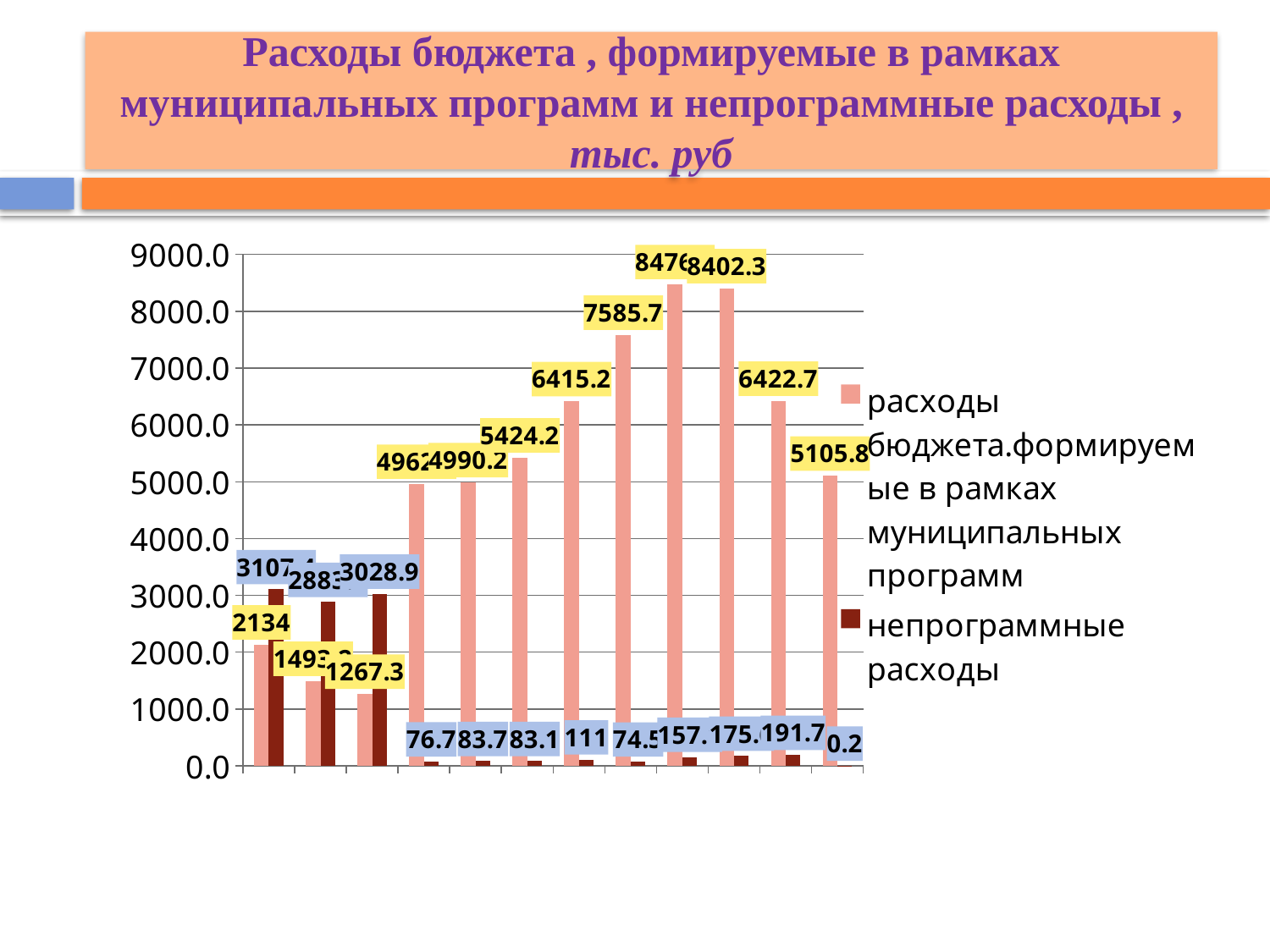
What is the lowest value in the 'непрограммные расходы' series? 0.2 In the first category, which series has the larger value: 'расходы бюджета, формируемые в рамках муниципальных программ' or 'непрограммные расходы'? непрограммные расходы What kind of chart is shown on the slide? bar chart What is the lowest value in the 'расходы бюджета, формируемые в рамках муниципальных программ' series? 1267.3 How many series does the legend list? 2 What is the difference between the last two 'расходы бюджета, формируемые в рамках муниципальных программ' values, 6422.7 and 5105.8? 1316.9 Is the highest bar in the 'расходы бюджета, формируемые в рамках муниципальных программ' series greater or less than 8000? greater In how many categories does the 'непрограммные расходы' bar exceed the 'расходы бюджета, формируемые в рамках муниципальных программ' bar? 3 What is the unit of measurement stated in the chart title? тыс. руб Which colour represents the 'непрограммные расходы' series? dark red How many categories (pairs of bars) are plotted in the chart? 12 What is the difference between the 'расходы бюджета, формируемые в рамках муниципальных программ' values labelled 8402.3 and 7585.7? 816.6